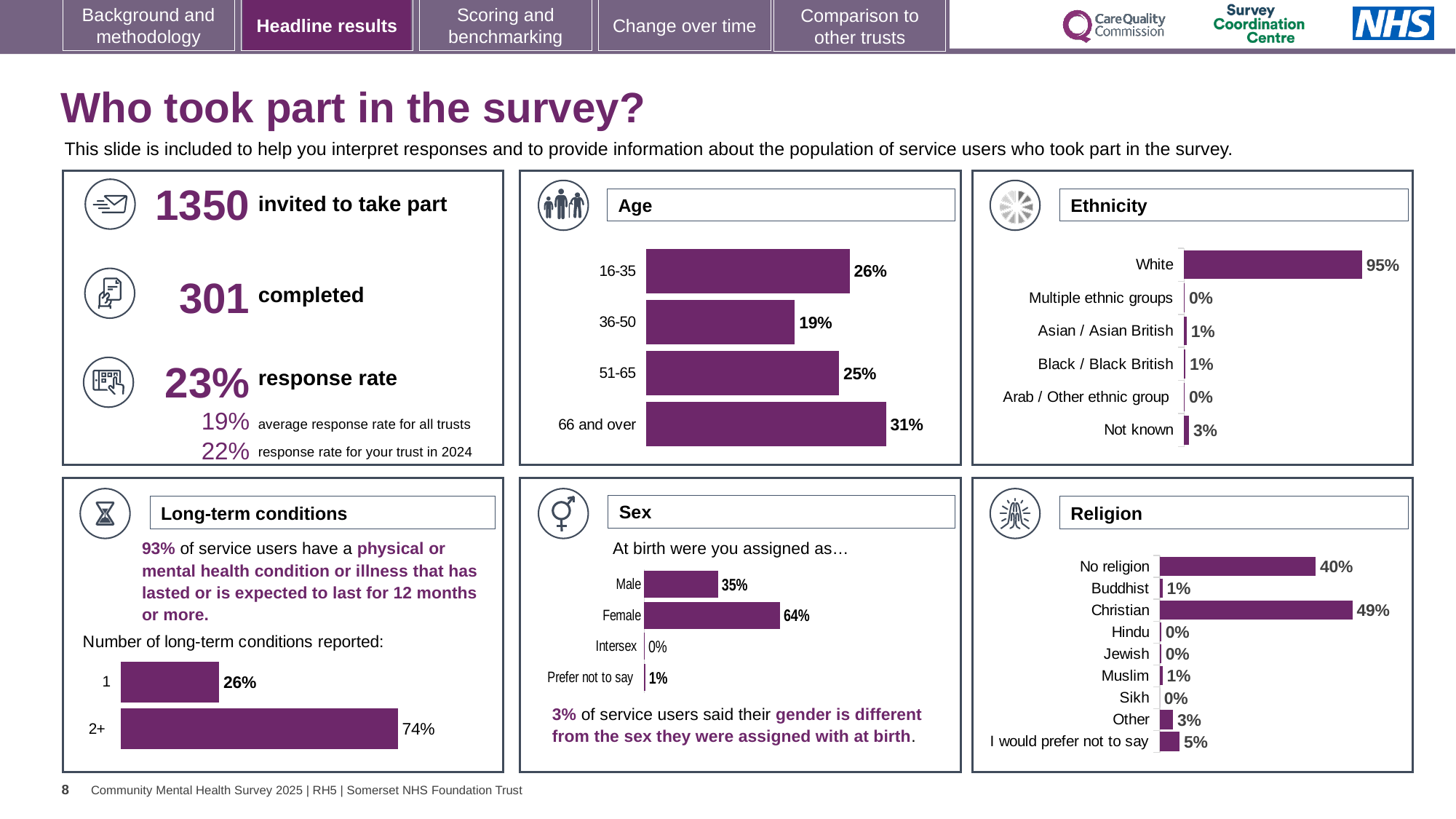
What kind of chart is the Age chart? Bar chart In the Religion chart, what percentage of respondents said No religion? 40% In the Age chart, what is the difference between the 16-35 and 36-50 percentages? 7% In the Ethnicity chart, what percentage of respondents were White? 95% In the Ethnicity chart, what percentage is shown for Not known? 3% In the Religion chart, which category has the highest percentage? Christian In the Age chart, which age group has the lowest percentage? 36-50 In the Long-term conditions chart, what percentage of service users reported 2+ conditions? 74% In the Sex chart, which is larger, Male or Female? Female In the Age chart, what percentage of respondents were aged 66 and over? 31% In the Sex chart, what percentage of respondents were assigned Female at birth? 64% How many categories does the Ethnicity chart show? 6